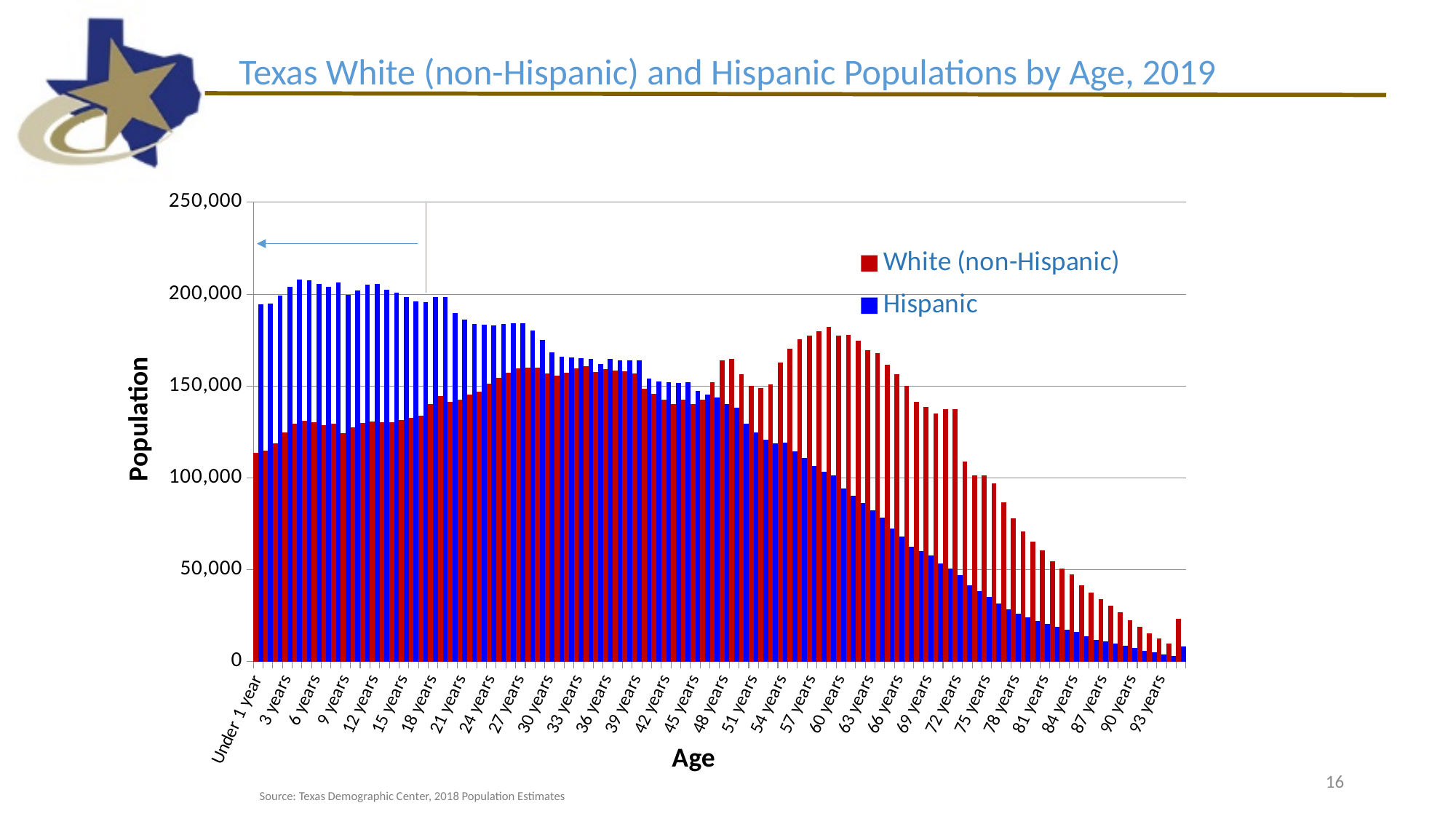
Is the White (non-Hispanic) value for 60 years greater or less than 150,000? greater What kind of chart is shown on the slide? bar chart How many series does the legend list? 2 Is the Hispanic value for 78 years greater or less than 50,000? less Which series has the larger value at 60 years, White (non-Hispanic) or Hispanic? White (non-Hispanic) Is the Hispanic value for 6 years greater or less than 200,000? greater Which series has the larger value at Under 1 year, White (non-Hispanic) or Hispanic? Hispanic Do the Hispanic values generally rise or fall as age increases along the x axis? fall What is the title of the x axis? Age Which series is shown in blue? Hispanic